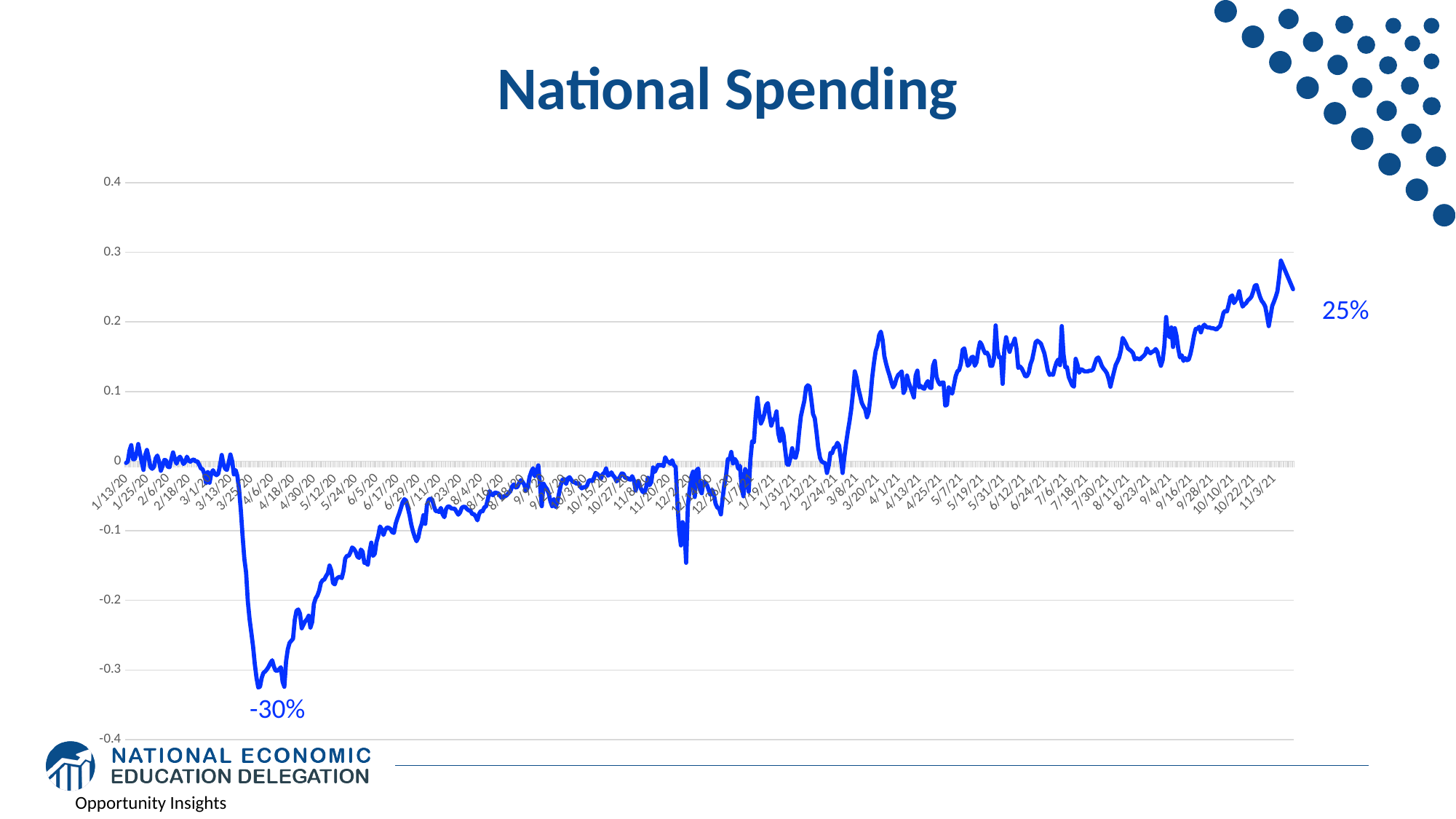
What is the difference in percentage points between the annotated end value (25%) and the annotated low point (-30%)? 55 percentage points Does the line generally rise or fall from its low point in late March 2020 to the end of the series in November 2021? rise What kind of chart is shown on the slide? line chart What is the title of the chart? National Spending What value is annotated at the lowest point of the line, around late March 2020? -30% How many lines are plotted on the chart? 1 What value is annotated at the right end of the line, near 11/3/21? 25% Is the value of the line around 4/1/21 greater or less than 0.1? greater Is the value of the line around 11/3/21 greater or less than 0.2? greater Which is larger, the value of the line around 11/3/21 or around 3/25/20? 11/3/21